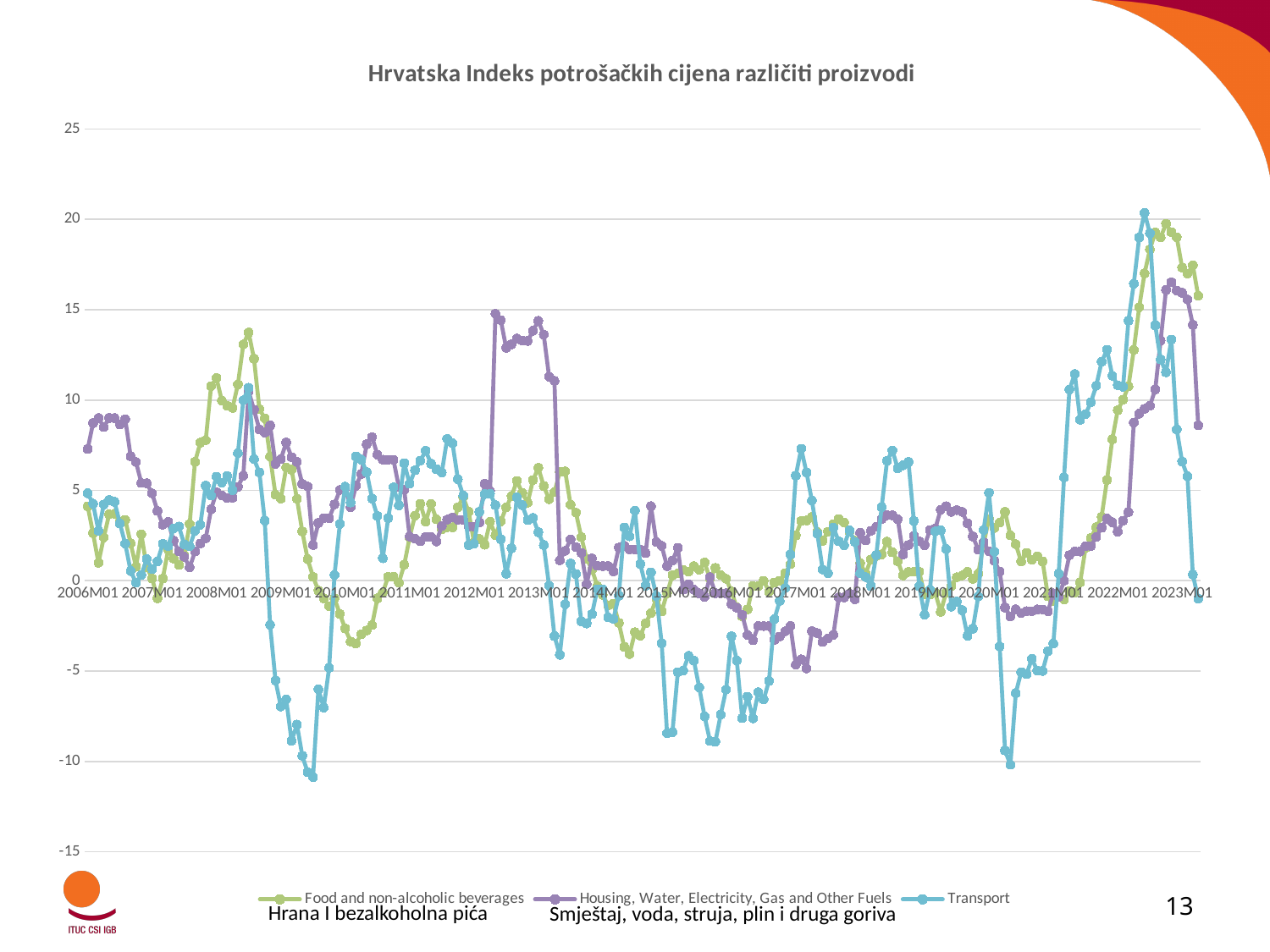
How many series does the legend list? 3 Is the lowest value of the Transport series (around 2009) greater or less than -10? less What is the title of the chart? Hrvatska Indeks potrošačkih cijena različiti proizvodi Is the highest value of the Food and non-alcoholic beverages series (around 2022-2023) greater or less than 15? greater How many year labels are shown on the x axis? 18 Which series reaches the lowest value anywhere on the chart? Transport Is the peak of the Transport series around 2022 greater or less than 15? greater What kind of chart is shown on the slide? line chart Which series has the highest value at 2006M01? Housing, Water, Electricity, Gas and Other Fuels Does the Food and non-alcoholic beverages series rise or fall between 2021M01 and 2023M01? rise Which colour is used for the Transport series? blue